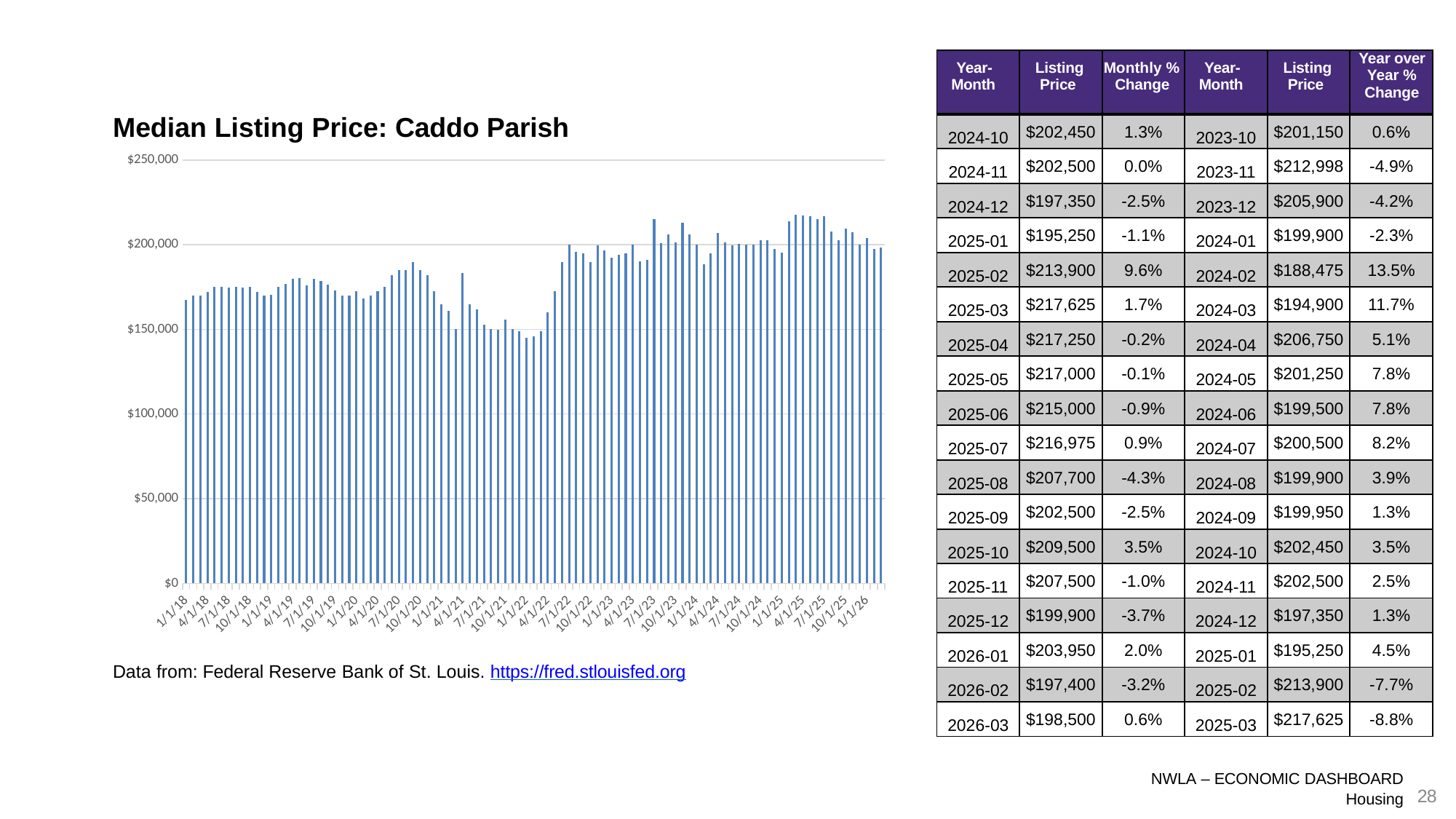
Is the value for 1/1/22 on the chart greater or less than $150,000? less Is the value for 4/1/25 on the chart greater or less than $200,000? greater What is the title of the chart on the slide? Median Listing Price: Caddo Parish Is the value for 1/1/18 on the chart greater or less than $150,000? greater Do the values on the chart generally rise or fall from 7/1/20 to 1/1/22? fall What kind of chart is shown on the slide? bar chart What is the highest value shown on the chart's vertical axis? $250,000 Do the values on the chart generally rise or fall from 1/1/22 to 7/1/23? rise Which is larger on the chart, the value for 1/1/22 or the value for 7/1/23? 7/1/23